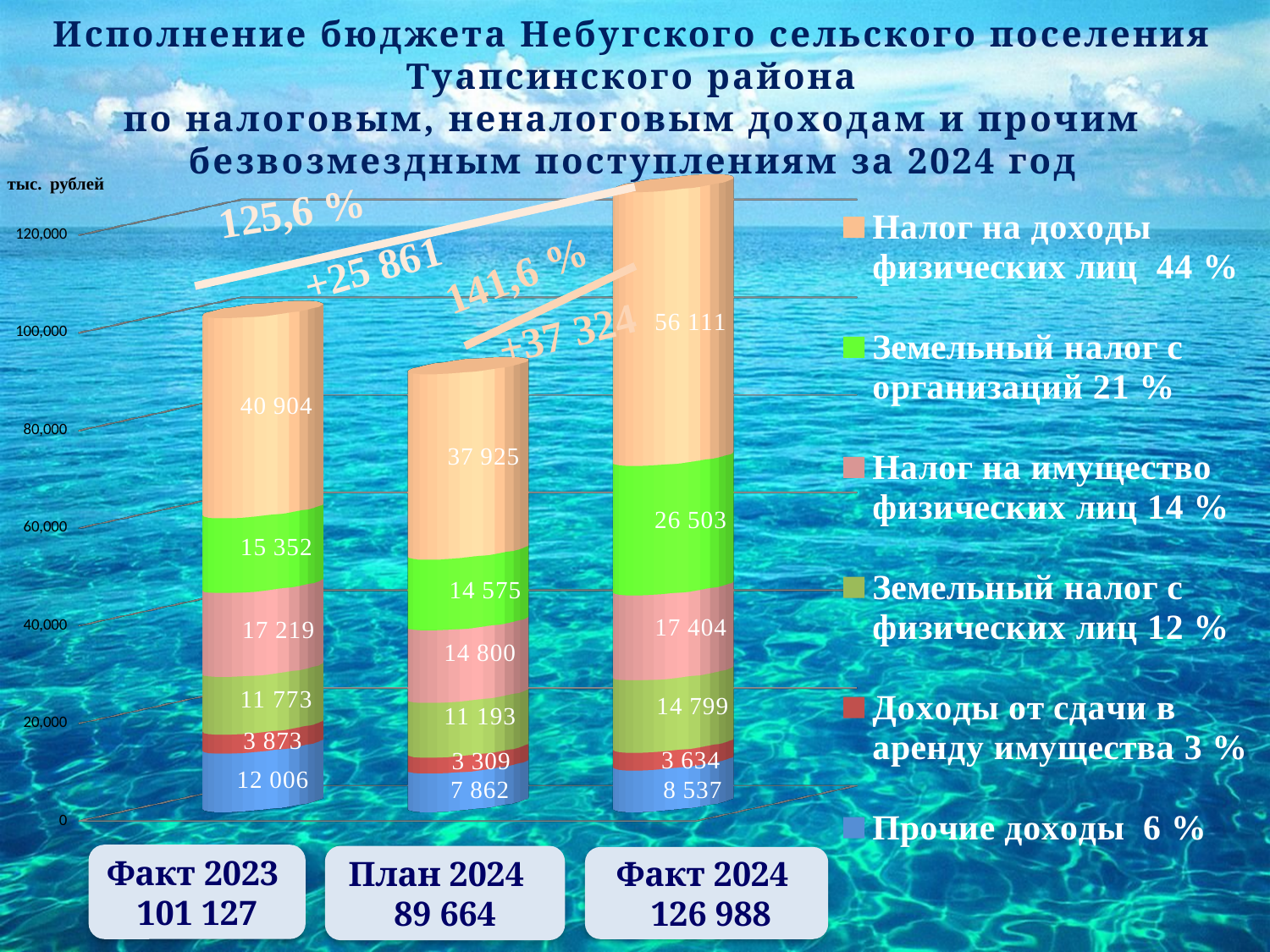
How many series does the legend list? 6 What is the difference between Земельный налог с организаций for Факт 2024 and for План 2024? 11 928 What is the value of Земельный налог с организаций for План 2024? 14 575 What is the total of the Факт 2024 bar? 126 988 How many bars are shown in the chart? 3 What is the value of Налог на доходы физических лиц for Факт 2024? 56 111 What is the difference between Налог на доходы физических лиц for Факт 2024 and for Факт 2023? 15 207 What kind of chart is shown on the slide? Stacked bar chart Which bar has the highest total? Факт 2024 Which bar has the lowest total? План 2024 What is the value of Прочие доходы for Факт 2023? 12 006 Which is larger: Прочие доходы for Факт 2023 or for Факт 2024? Факт 2023